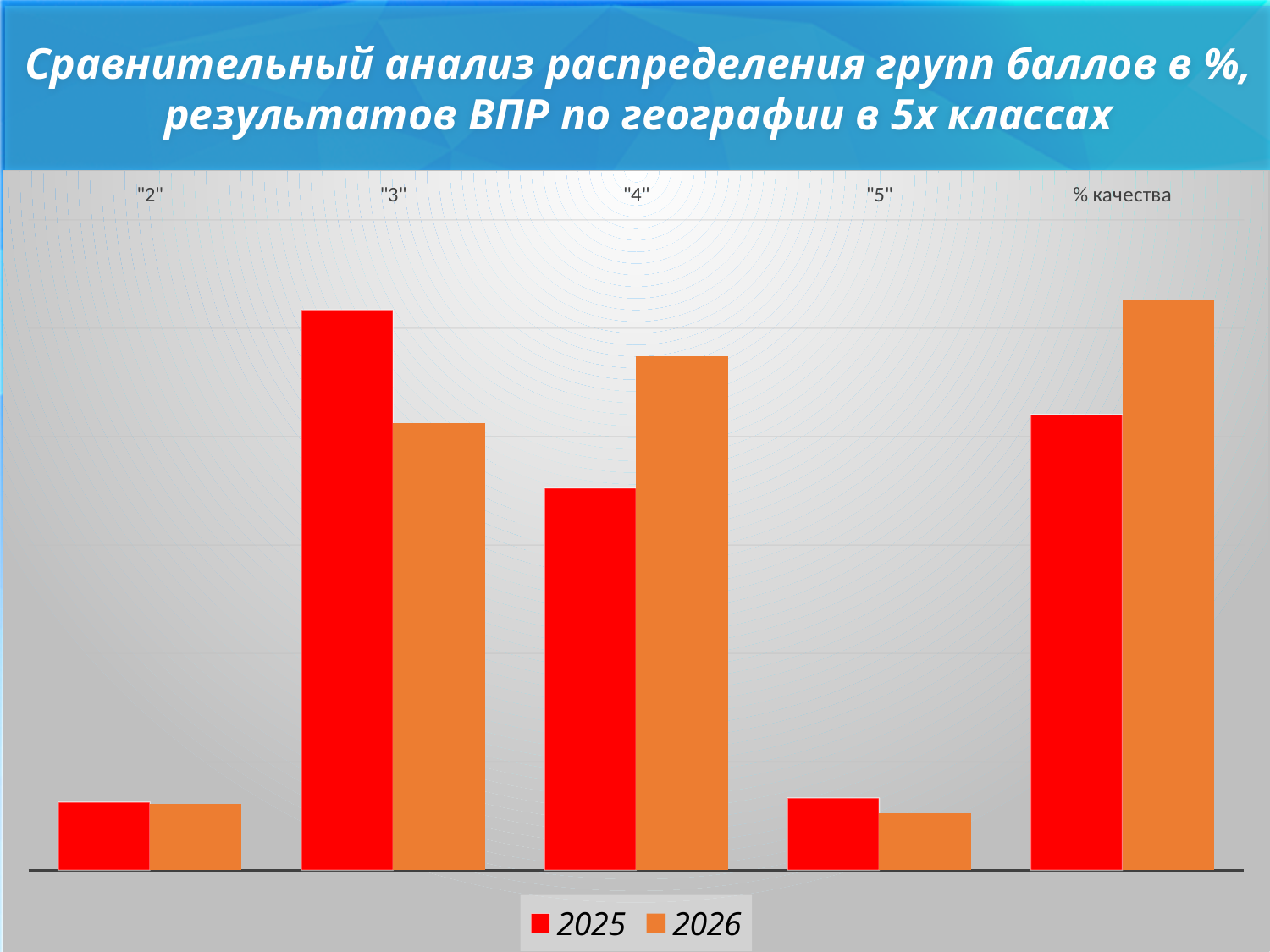
For the category "3", which series has the larger value, 2025 or 2026? 2025 How many series does the legend list? 2 Which category has the highest value for the 2026 series? % качества For the category "% качества", which series has the larger value, 2025 or 2026? 2026 For the category "5", which series has the larger value, 2025 or 2026? 2025 What kind of chart is shown on the slide? bar chart Which category has the highest value for the 2025 series? "3" What are the two entries listed in the legend? 2025 and 2026 Which series is shown in red? 2025 How many categories are shown along the x axis? 5